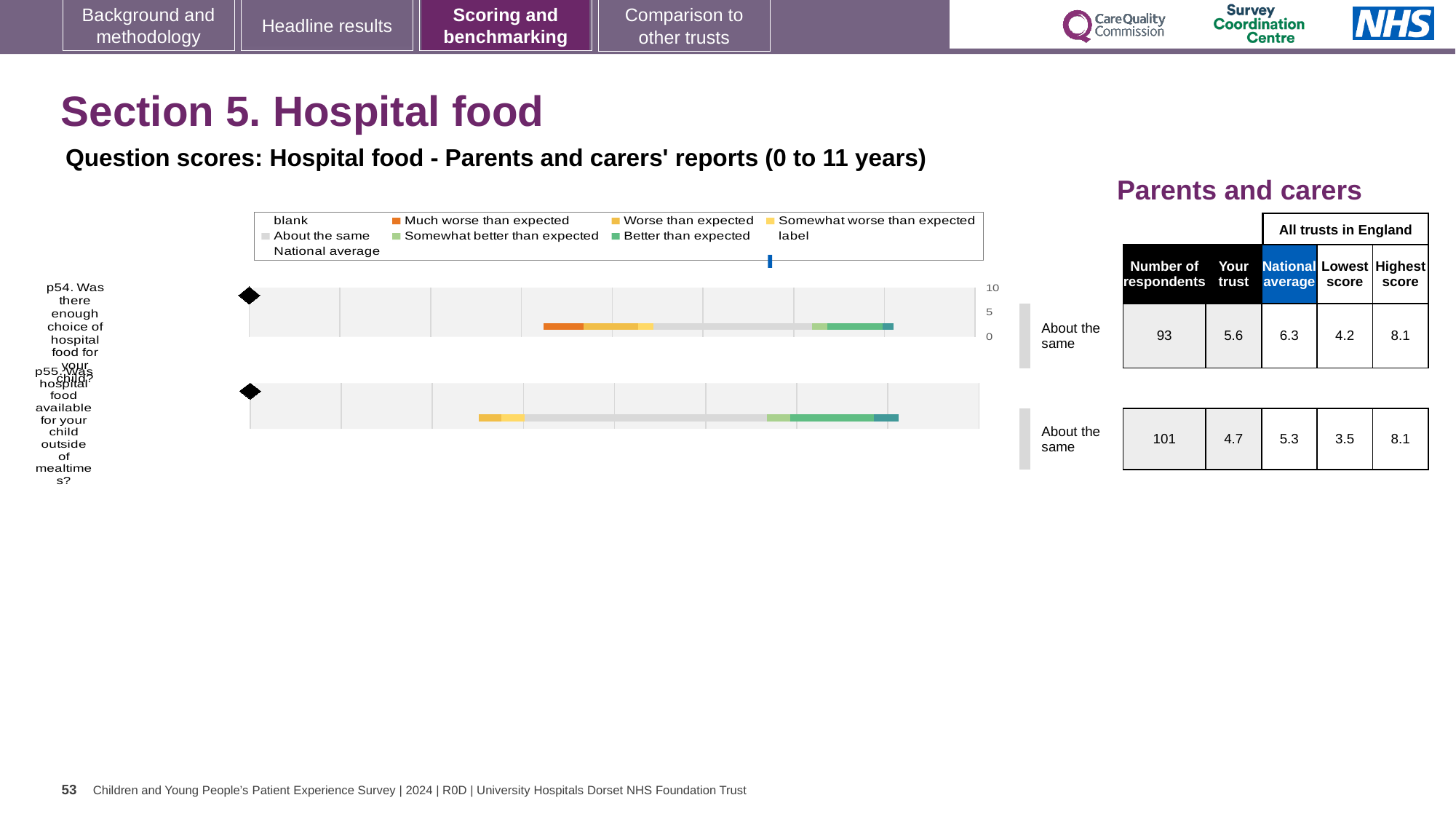
What is the highest score across all trusts in England for p55? 8.1 What is the highest value shown on the chart's score axis? 10 How many survey questions (bars) are plotted in the hospital food chart? 2 In the table next to the chart, what is the national average score for p55 (hospital food available outside of mealtimes)? 5.3 What kind of chart is used to show the question scores for hospital food? bar chart Which question had more respondents, p54 or p55? p55 What is the difference between the highest score and the lowest score for p54 in the table? 3.9 How many respondents answered question p54 according to the table? 93 What benchmark category label is shown beside both bars in the chart? About the same Which colour in the legend represents 'Much worse than expected'? orange For p54, which is larger: the 'Your trust' score or the national average? National average In the table next to the chart, what is the 'Your trust' score for p54 (enough choice of hospital food)? 5.6